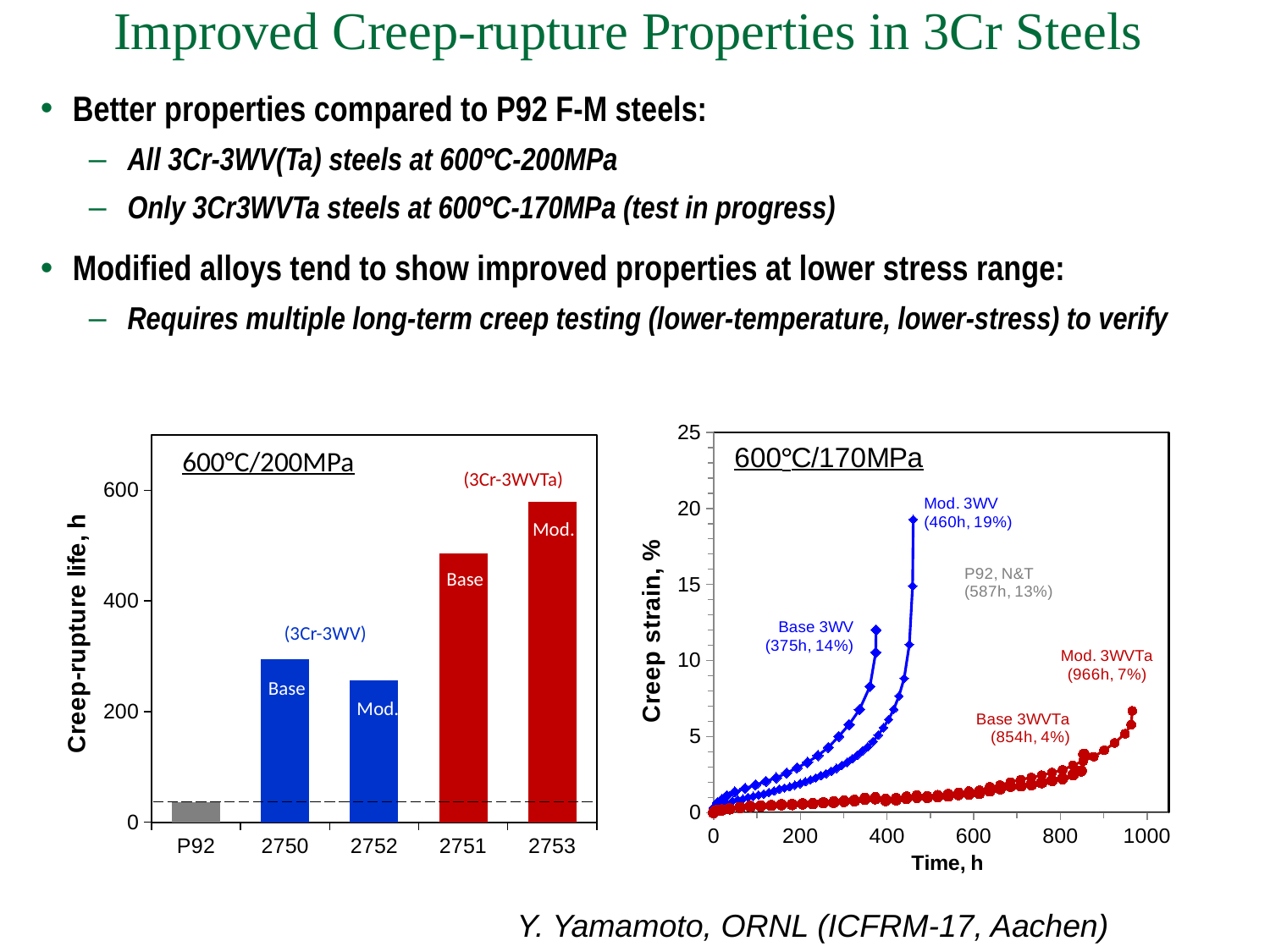
What kind of chart is the 600°C/200MPa chart on the left? bar chart In the 600°C/200MPa chart, which has a longer creep-rupture life, 2750 or 2752? 2750 In the 600°C/170MPa chart, what rupture time and strain are given for Mod. 3WV? 460h, 19% In the 600°C/200MPa chart, is the creep-rupture life for 2753 greater or less than 400 h? greater In the 600°C/170MPa chart, what is the difference in rupture time between Mod. 3WVTa (966h) and Base 3WVTa (854h)? 112h What is the label on the y axis of the 600°C/170MPa chart? Creep strain, % In the 600°C/170MPa chart, which alloy has the longest rupture time according to the labels? Mod. 3WVTa In the 600°C/200MPa chart, which category has the lowest creep-rupture life? P92 In the 600°C/200MPa chart, is the creep-rupture life for 2752 greater or less than 400 h? less How many categories are shown on the x axis of the 600°C/200MPa bar chart? 5 In the 600°C/170MPa chart, what rupture time is given for P92, N&T? 587h In the 600°C/200MPa chart, which category has the highest creep-rupture life? 2753